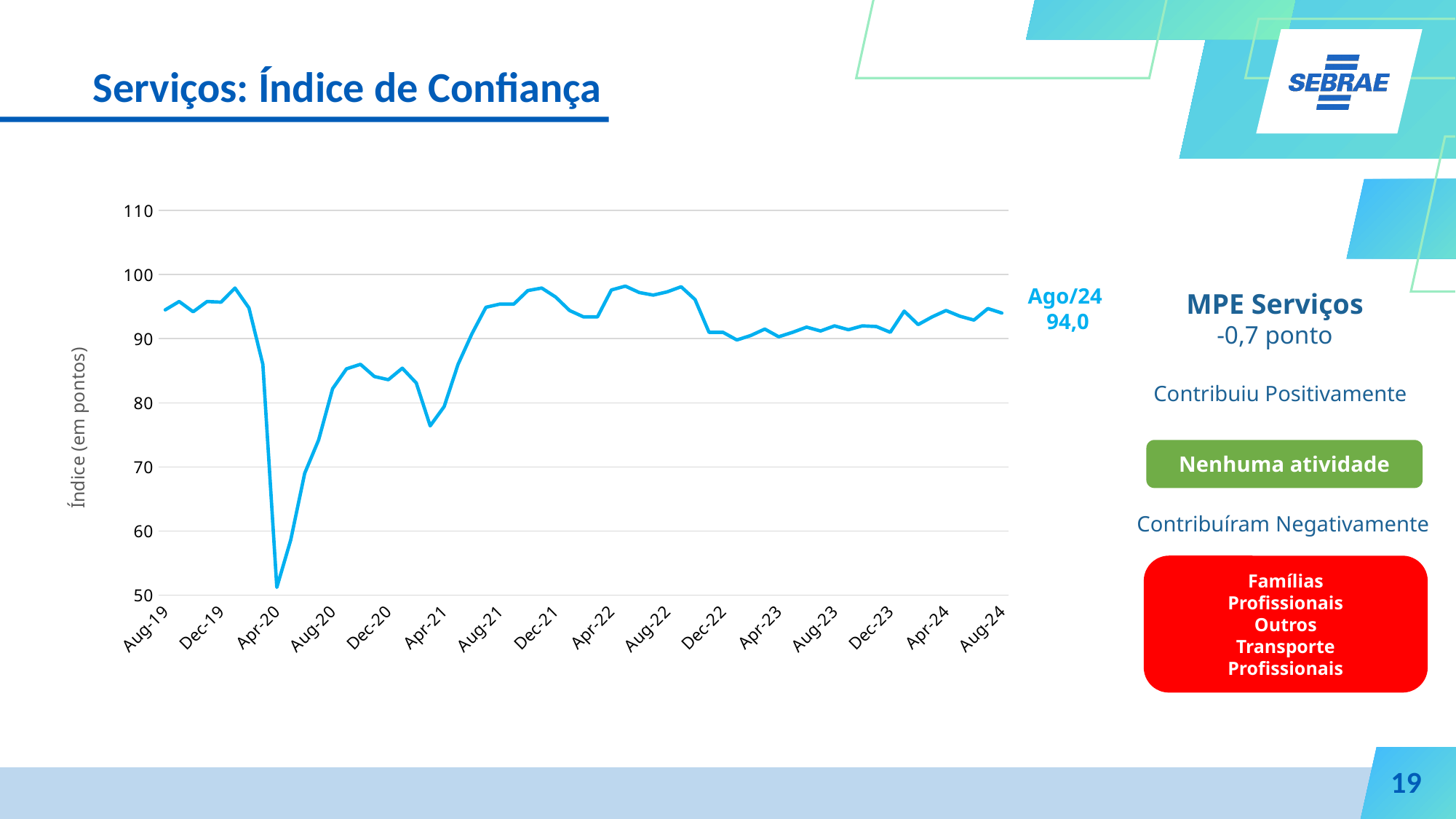
Is the value for Dec-21 greater or less than 90? greater Is the value for Aug-19 greater or less than 90? greater What is the title of the vertical axis? Índice (em pontos) What kind of chart is shown on the slide? line chart Which is larger, the value for Aug-19 or the value for Apr-20? Aug-19 Is the value for Apr-20 greater or less than 60? less Does the index rise or fall between Dec-19 and Apr-20? fall What is the value of the index for Aug-24 (Ago/24) shown on the chart? 94,0 How many lines (series) are plotted on the chart? 1 At which x-axis label does the index reach its lowest point? Apr-20